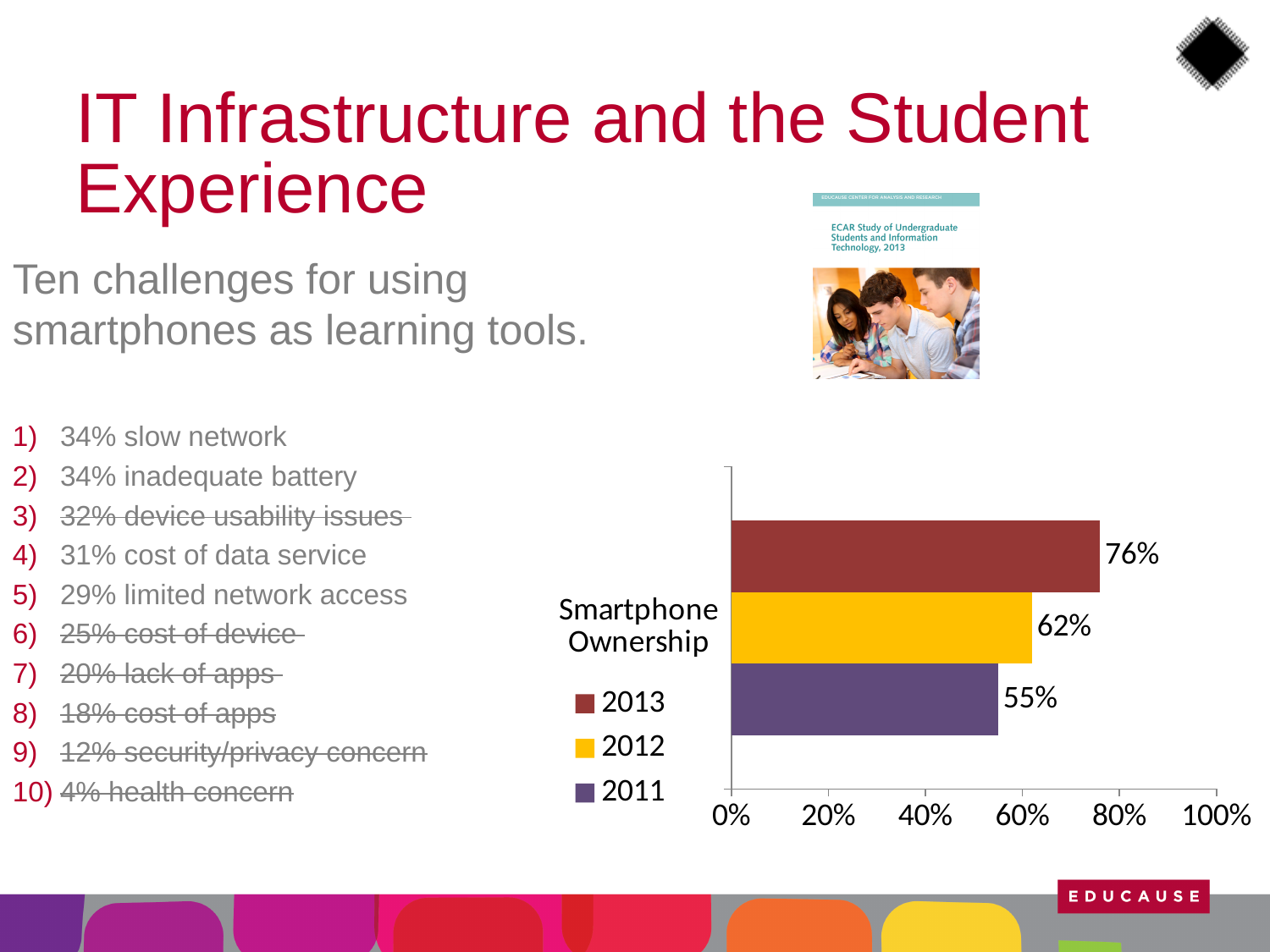
How many series does the legend list? 3 Which year has the highest smartphone ownership? 2013 What is the category label shown next to the bars? Smartphone Ownership Which is larger, smartphone ownership in 2012 or in 2011? 2012 What is the smartphone ownership value for 2011? 55% Is the smartphone ownership value for 2013 greater or less than 80%? less What kind of chart is shown on the slide? bar chart What is the smartphone ownership value for 2012? 62% Which year has the lowest smartphone ownership? 2011 What is the difference in smartphone ownership between 2012 and 2011? 7% What is the difference in smartphone ownership between 2013 and 2011? 21% What is the smartphone ownership value for 2013? 76%